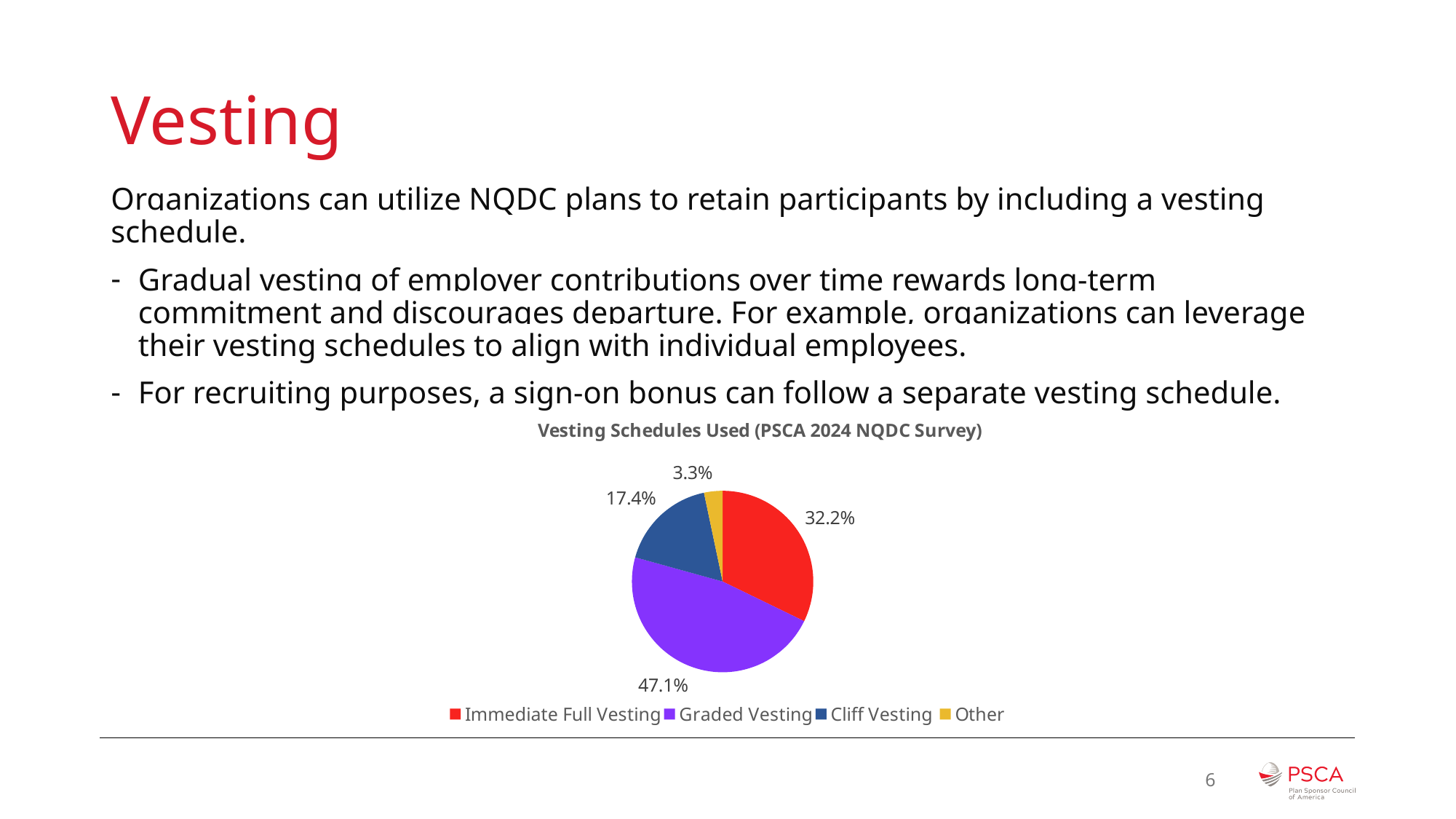
Which vesting schedule has the largest slice of the pie? Graded Vesting What share of the pie is Immediate Full Vesting? 32.2% What share of the pie is Cliff Vesting? 17.4% How many categories does the pie chart show? 4 What share of the pie is Other? 3.3% Which is larger, the share for Cliff Vesting or the share for Immediate Full Vesting? Immediate Full Vesting Which vesting schedule has the smallest slice of the pie? Other What is the title of the chart? Vesting Schedules Used (PSCA 2024 NQDC Survey) What type of chart is shown on the slide? pie chart What colour is the Cliff Vesting slice? dark blue What is the difference in percentage points between Graded Vesting and Immediate Full Vesting? 14.9